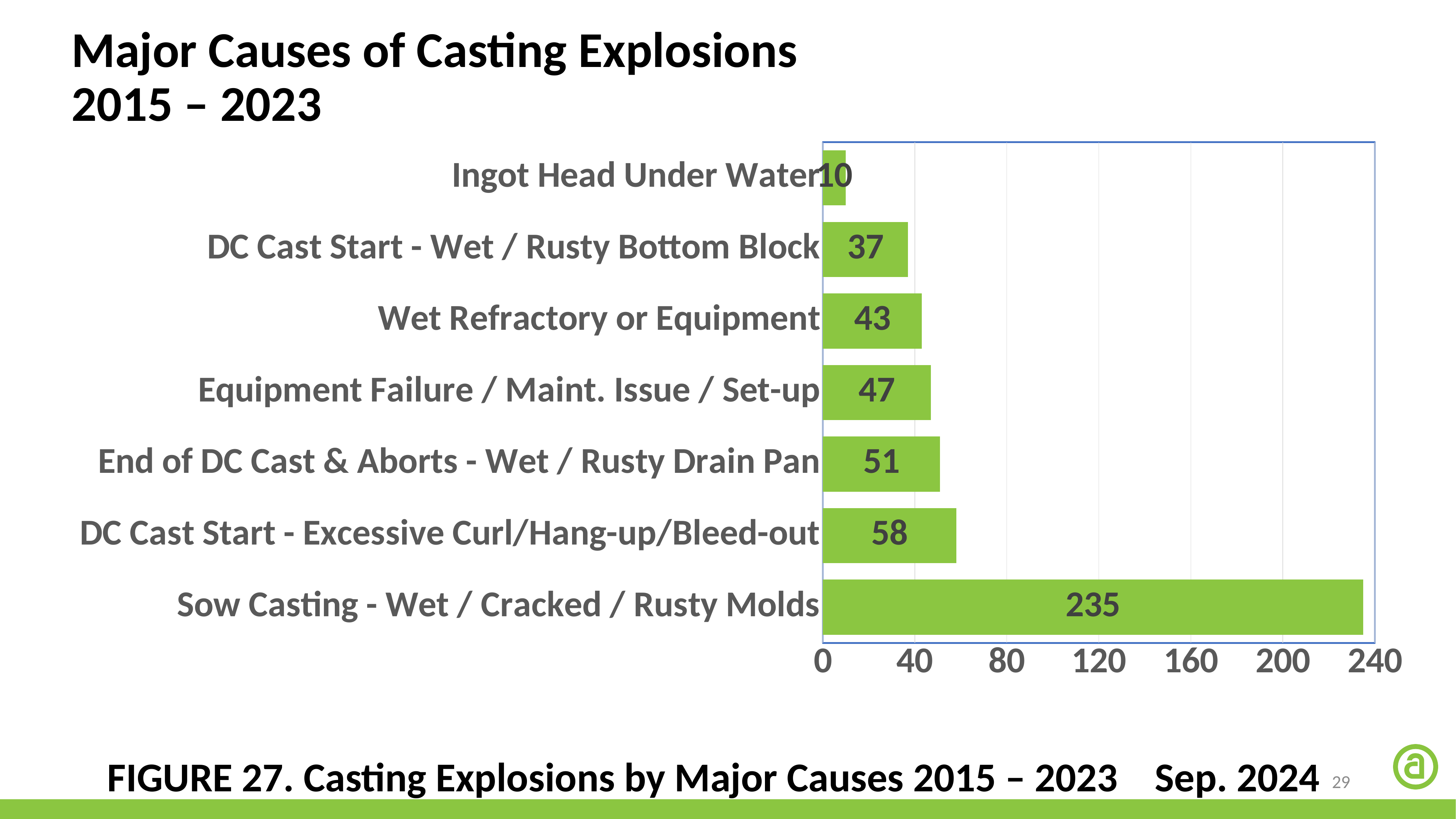
What is the difference between the values for Equipment Failure / Maint. Issue / Set-up and Wet Refractory or Equipment? 4 What is the value for DC Cast Start - Wet / Rusty Bottom Block? 37 What is the value for End of DC Cast & Aborts - Wet / Rusty Drain Pan? 51 What is the difference between the values for Sow Casting - Wet / Cracked / Rusty Molds and DC Cast Start - Excessive Curl/Hang-up/Bleed-out? 177 What kind of chart is shown on the slide? bar chart Is the value for Sow Casting - Wet / Cracked / Rusty Molds greater or less than 200? greater How many causes are shown in the chart? 7 Which is larger, the value for DC Cast Start - Excessive Curl/Hang-up/Bleed-out or the value for Ingot Head Under Water? DC Cast Start - Excessive Curl/Hang-up/Bleed-out Which cause has the highest number of casting explosions? Sow Casting - Wet / Cracked / Rusty Molds Which cause has the lowest number of casting explosions? Ingot Head Under Water What is the value for Sow Casting - Wet / Cracked / Rusty Molds? 235 What is the value for Wet Refractory or Equipment? 43